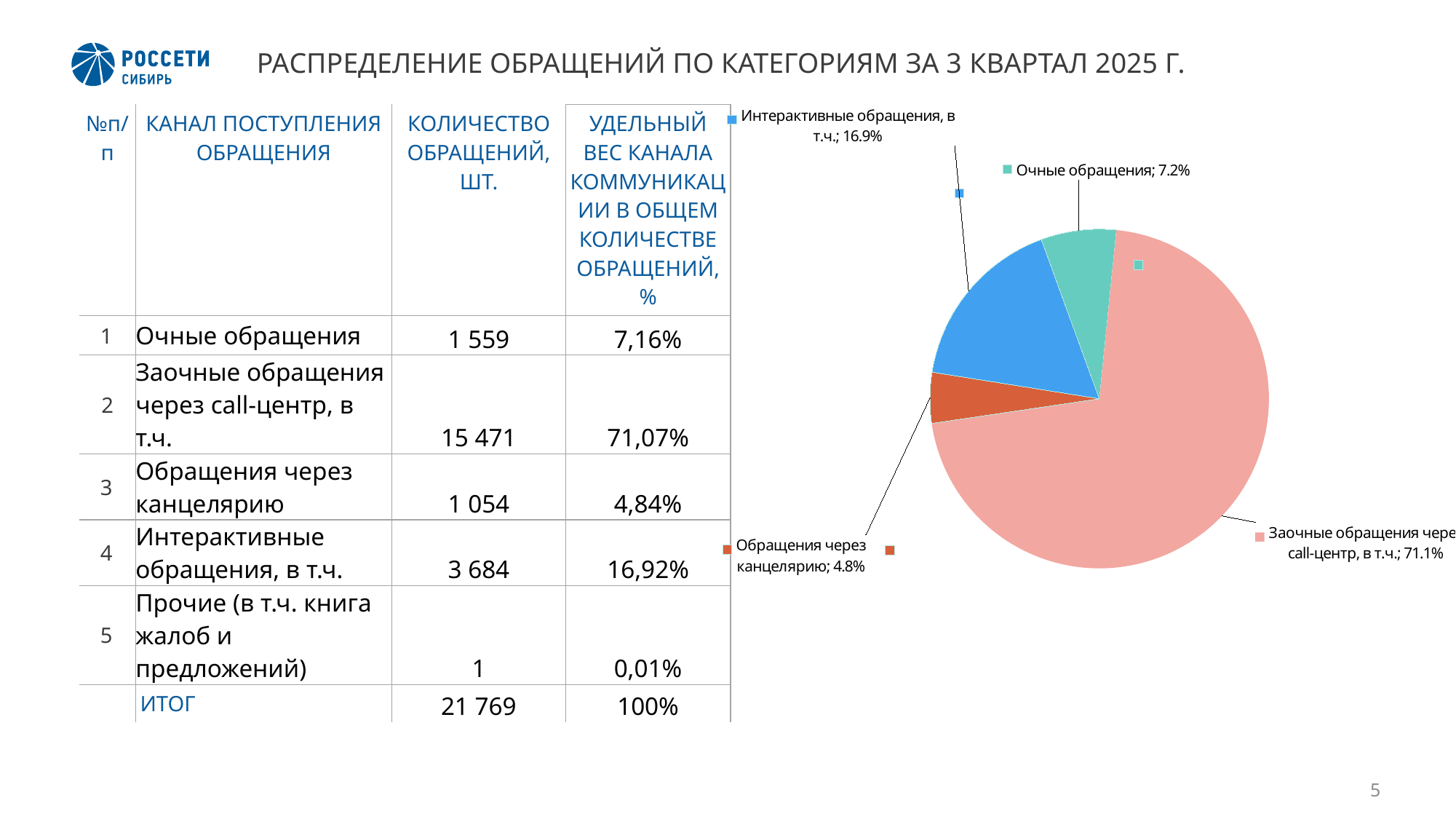
What is the title of the slide containing the pie chart? РАСПРЕДЕЛЕНИЕ ОБРАЩЕНИЙ ПО КАТЕГОРИЯМ ЗА 3 КВАРТАЛ 2025 Г. Which labelled category has the smallest slice of the pie? Обращения через канцелярию What colour is the slice for "Заочные обращения через call-центр, в т.ч." in the pie chart? Pink (salmon) By how many percentage points does the share of "Заочные обращения через call-центр, в т.ч." exceed that of "Интерактивные обращения, в т.ч." according to the pie labels? 54.2% What share of the pie is labelled for "Заочные обращения через call-центр, в т.ч."? 71.1% Which slice is larger: "Очные обращения" or "Обращения через канцелярию"? Очные обращения Which category has the largest slice of the pie? Заочные обращения через call-центр, в т.ч. What share of the pie is labelled for "Интерактивные обращения, в т.ч."? 16.9% What share of the pie is labelled for "Обращения через канцелярию"? 4.8% What kind of chart is shown on the slide? Pie chart By how many percentage points does the share of "Интерактивные обращения, в т.ч." exceed that of "Очные обращения" according to the pie labels? 9.7% What share of the pie is labelled for "Очные обращения"? 7.2%